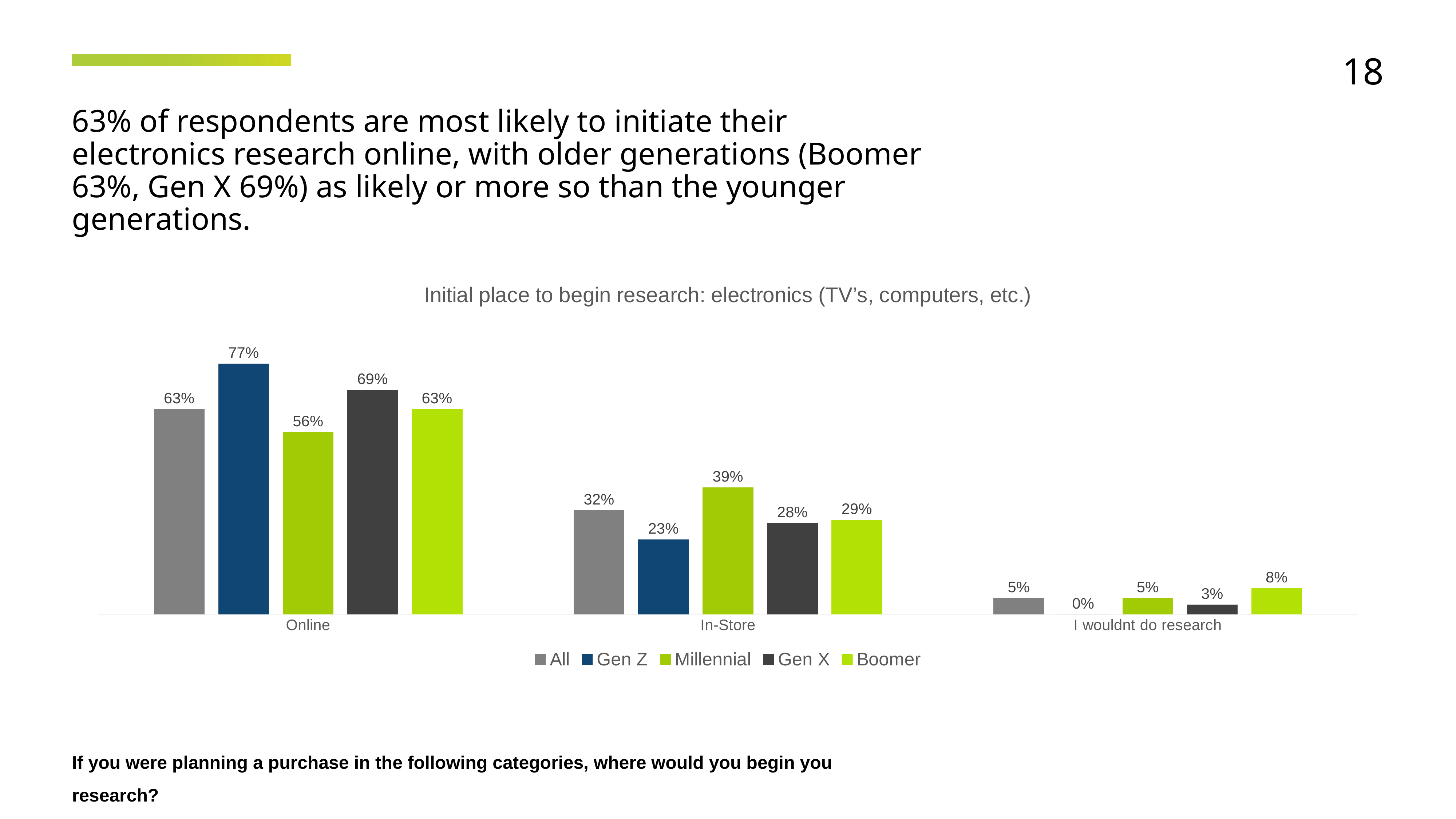
What is the title of the chart? Initial place to begin research: electronics (TV's, computers, etc.) What kind of chart is shown on the slide? Bar chart What is the value for All in the In-Store category? 32% How many series does the legend list? 5 Which series has the highest value in the Online category? Gen Z What is the value for Boomer in the 'I wouldnt do research' category? 8% What is the value for Gen Z in the Online category? 77% Which series has the lowest value in the 'I wouldnt do research' category? Gen Z What is the value for Millennial in the In-Store category? 39% What is the difference between the Gen Z and Millennial values in the Online category? 21% How many categories are shown on the x axis? 3 Which is larger in the In-Store category: the value for Gen X or the value for Boomer? Boomer